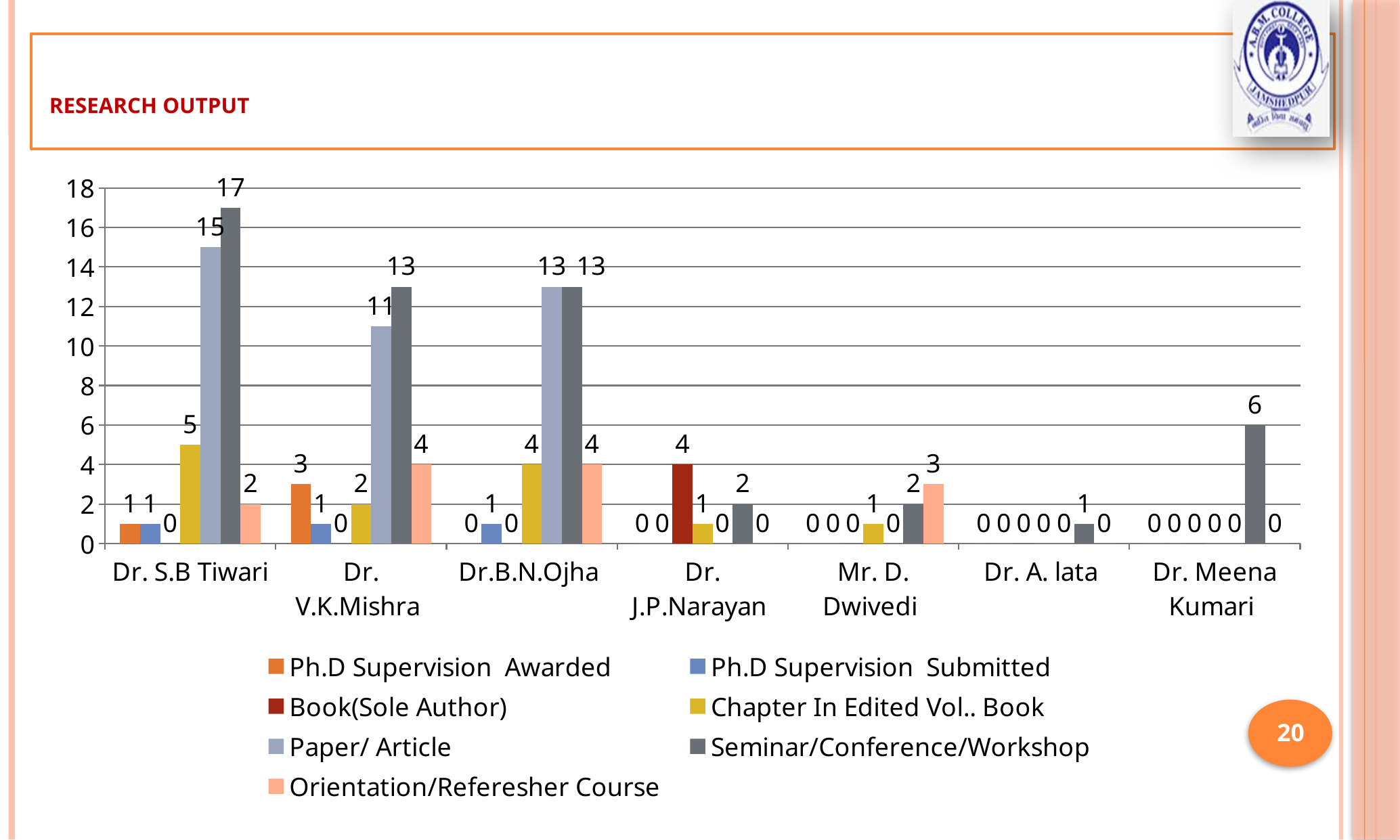
How many series does the legend list? 7 Which is larger: the Orientation/Referesher Course value for Mr. D. Dwivedi or for Dr. S.B Tiwari? Mr. D. Dwivedi Which faculty member has the highest Seminar/Conference/Workshop value? Dr. S.B Tiwari What type of chart is shown on the slide? bar chart What is the Seminar/Conference/Workshop value for Dr. Meena Kumari? 6 What is the title of the slide containing the chart? RESEARCH OUTPUT What is the Paper/ Article value for Dr. V.K.Mishra? 11 Which faculty member has the highest Chapter In Edited Vol.. Book value? Dr. S.B Tiwari What is the Seminar/Conference/Workshop value for Dr. S.B Tiwari? 17 What is the Book(Sole Author) value for Dr. J.P.Narayan? 4 What is the difference between the Paper/ Article values for Dr. S.B Tiwari and Dr. V.K.Mishra? 4 How many faculty members (categories) are shown on the x axis? 7